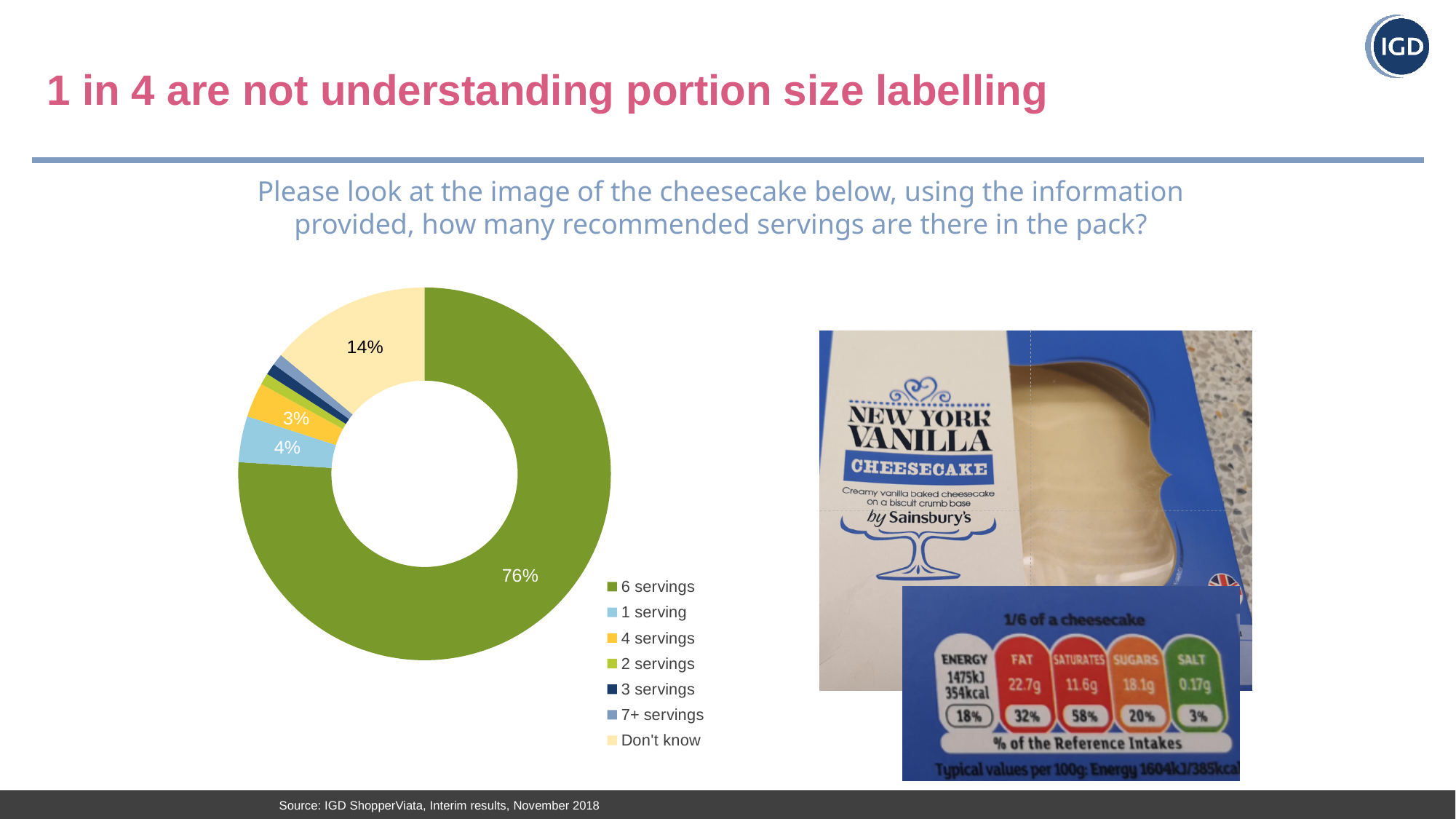
What percentage of respondents answered "6 servings"? 76% What percentage of respondents answered "Don't know"? 14% What kind of chart is shown on the slide? Donut (pie) chart How many response categories does the legend list? 7 Which response has the largest share of the chart? 6 servings What percentage of respondents answered "1 serving"? 4% What is the difference in percentage points between "6 servings" and "Don't know"? 62 Which is larger, the share for "Don't know" or the share for "1 serving"? Don't know Which legend entry is shown in dark blue? 3 servings What percentage of respondents answered "4 servings"? 3% What is the combined share of "6 servings" and "Don't know"? 90% Which is larger, the share for "1 serving" or the share for "4 servings"? 1 serving